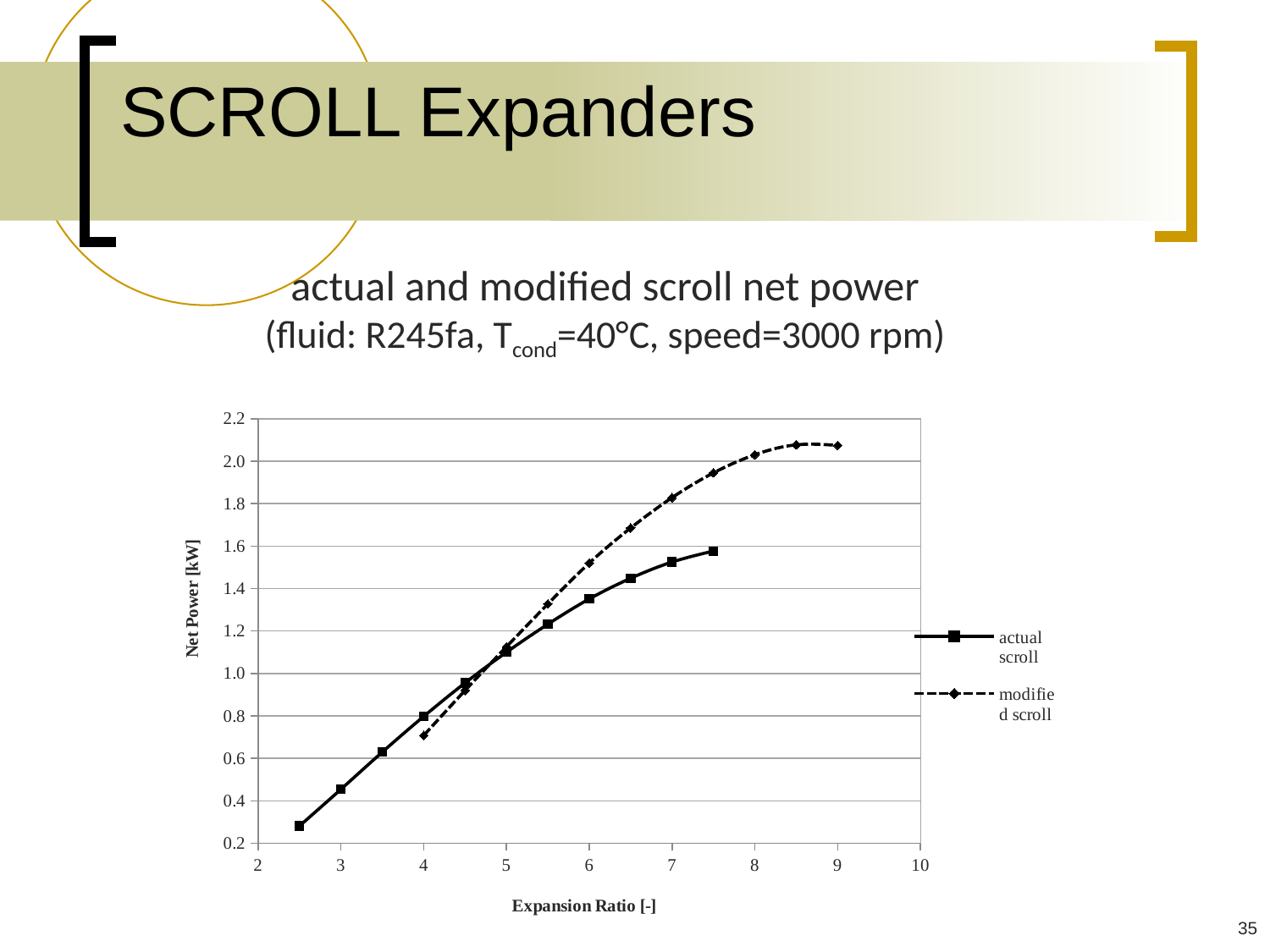
Is the net power of the actual scroll at an expansion ratio of 3 greater or less than 0.6? less How many series does the legend list? 2 Does the net power of the actual scroll rise or fall as the expansion ratio increases? rise At an expansion ratio of 4, which series has the higher net power, actual scroll or modified scroll? actual scroll What is the label of the y axis? Net Power [kW] Is the net power of the actual scroll at an expansion ratio of 2.5 greater or less than 0.4? less What kind of chart is shown on the slide? line chart Is the net power of the modified scroll at an expansion ratio of 9 greater or less than 2.0? greater At an expansion ratio of 7, which series has the higher net power, actual scroll or modified scroll? modified scroll What are the two series named in the legend? actual scroll, modified scroll Which series reaches the highest net power on the chart? modified scroll